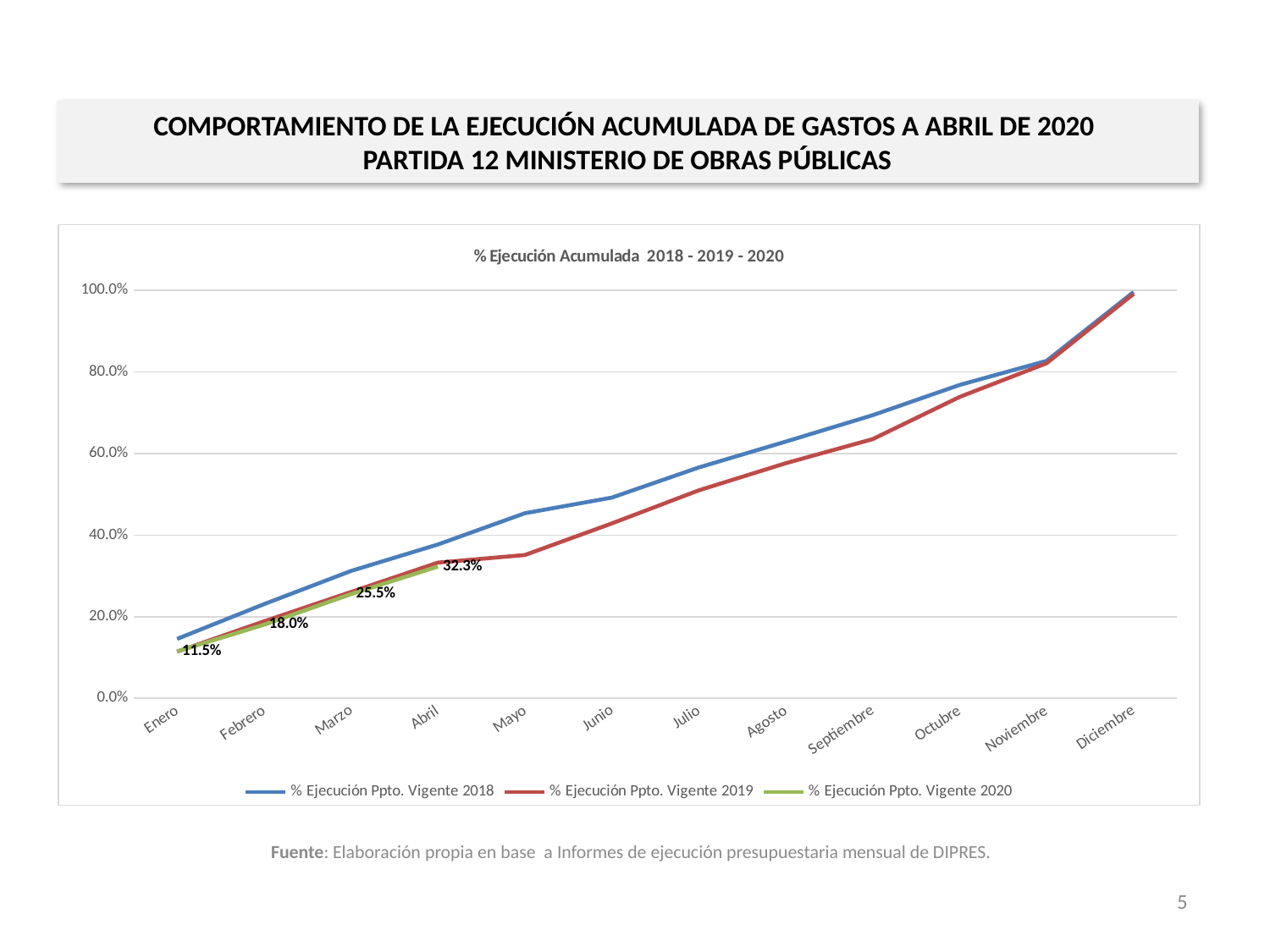
In Septiembre, which series has the larger value: % Ejecución Ppto. Vigente 2018 or % Ejecución Ppto. Vigente 2019? % Ejecución Ppto. Vigente 2018 Is the value for % Ejecución Ppto. Vigente 2018 in Mayo greater or less than 40%? greater What kind of chart is shown on the slide? Line chart Do the values for % Ejecución Ppto. Vigente 2018 rise or fall from Enero to Diciembre? Rise How many months are shown on the x axis? 12 How many series does the legend list? 3 Is the value for % Ejecución Ppto. Vigente 2019 in Septiembre greater or less than 80%? less What is the value for % Ejecución Ppto. Vigente 2020 in Marzo? 25.5% What is the difference between the 2020 values for Abril and Enero? 20.8 percentage points What is the value for % Ejecución Ppto. Vigente 2020 in Abril? 32.3% What is the value for % Ejecución Ppto. Vigente 2020 in Enero? 11.5% Which month has the highest value for the % Ejecución Ppto. Vigente 2020 series? Abril